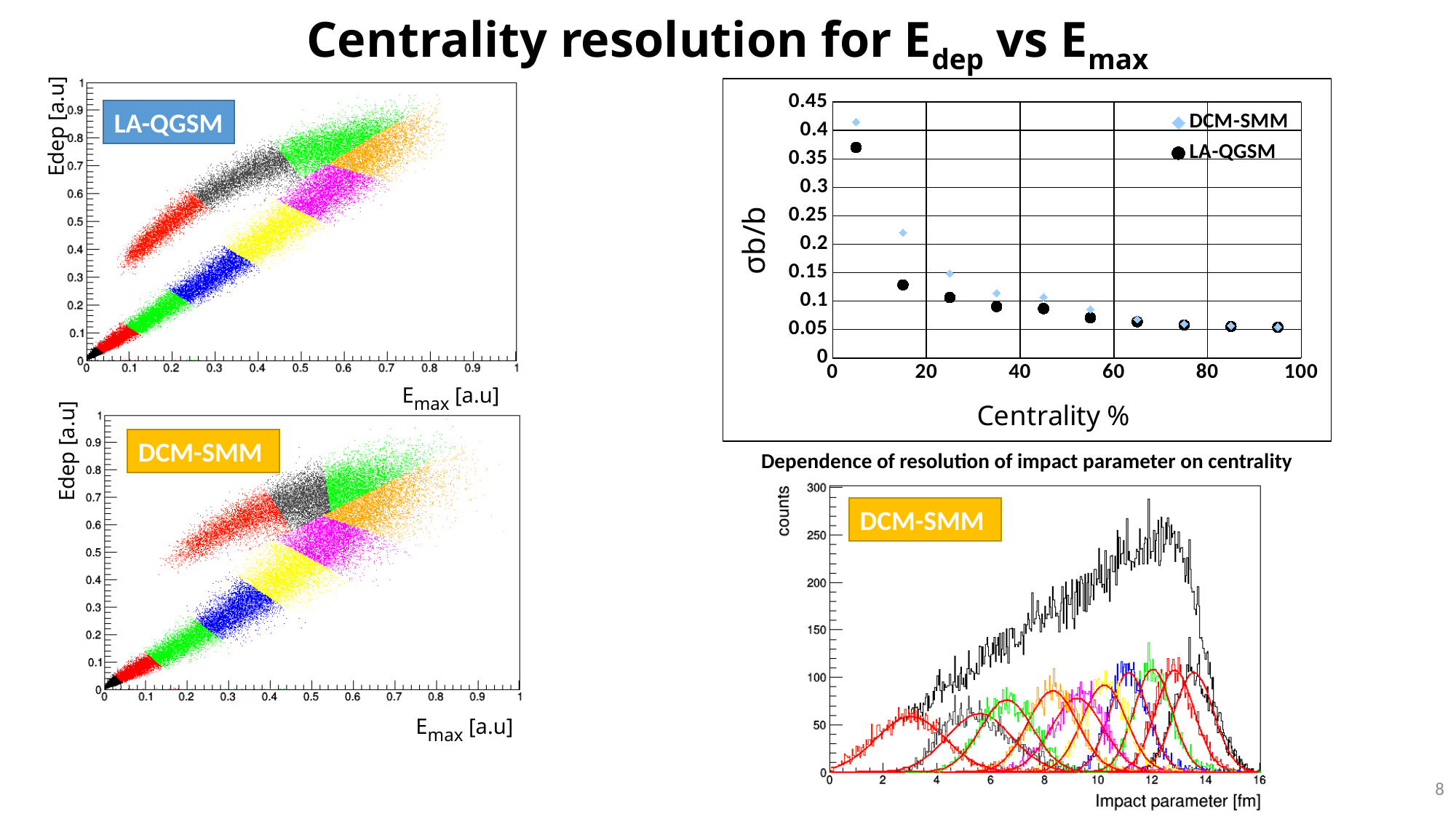
In the σb/b vs Centrality % chart, how many data points are plotted for the DCM-SMM series? 10 In the σb/b vs Centrality % chart, which two series are listed in the legend? DCM-SMM and LA-QGSM In the DCM-SMM histogram at the bottom right, what is the x-axis label? Impact parameter [fm] What kind of chart is the chart titled 'Dependence of resolution of impact parameter on centrality'? scatter chart In the DCM-SMM histogram at the bottom right, is the peak of the black histogram greater or less than 300 counts? less In the σb/b vs Centrality % chart, is the DCM-SMM value at about 95% centrality greater or less than 0.1? less In the σb/b vs Centrality % chart, at the lowest centrality (about 5%), which series has the larger σb/b, DCM-SMM or LA-QGSM? DCM-SMM In the σb/b vs Centrality % chart, is the LA-QGSM value at about 15% centrality greater or less than 0.15? less How many series does the legend list in the σb/b vs Centrality % chart? 2 In the σb/b vs Centrality % chart, does σb/b rise or fall as centrality increases? fall